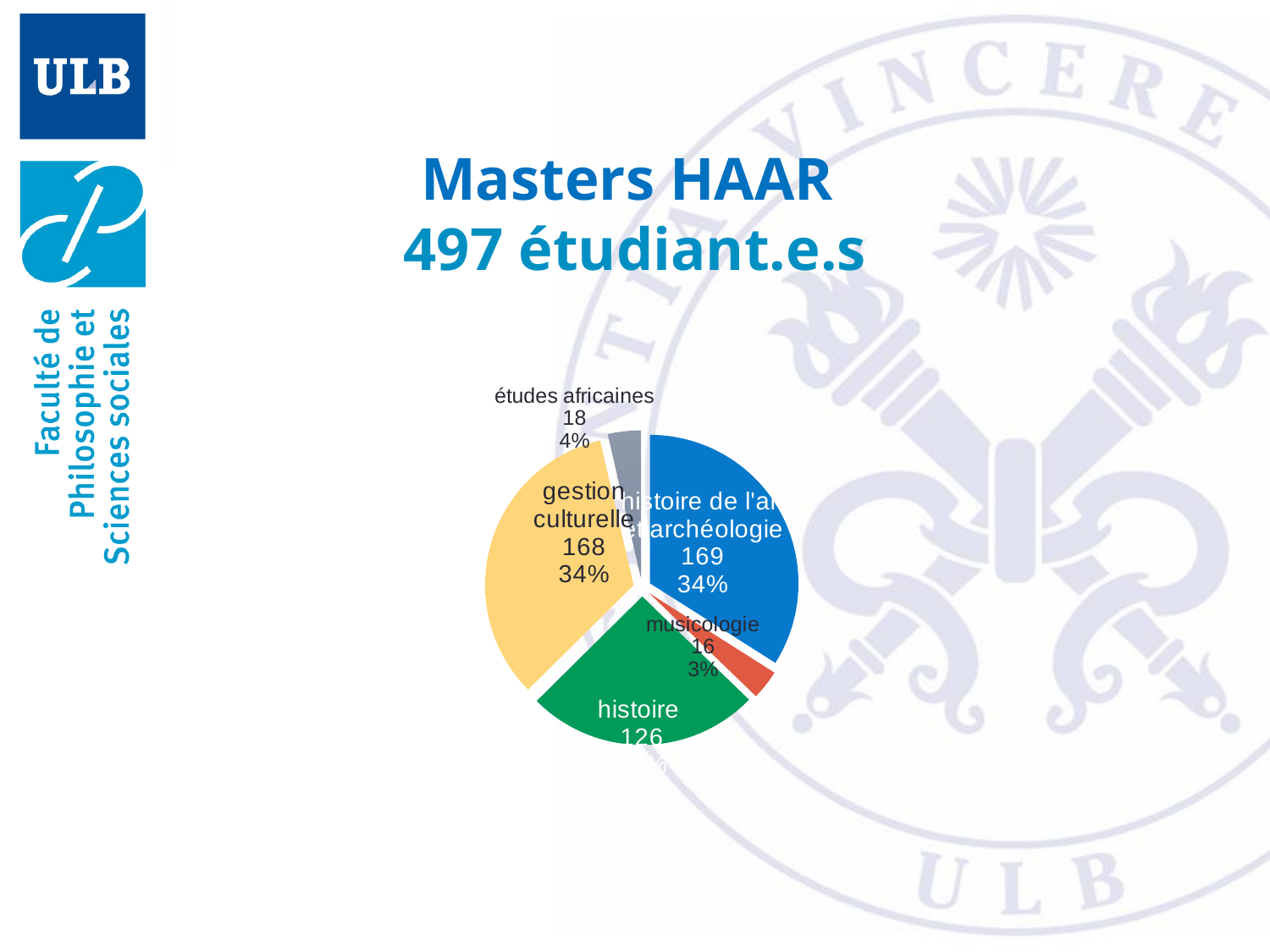
How many students are in gestion culturelle? 168 What percentage of the pie does musicologie represent? 3% What colour is the histoire slice? green What is the difference in student numbers between gestion culturelle and histoire? 42 How many slices does the pie chart have? 5 Which has more students, histoire or gestion culturelle? gestion culturelle What kind of chart is shown on the slide? pie chart How many students are in histoire? 126 How many students are in histoire de l'art et archéologie? 169 What is the difference in student numbers between études africaines and musicologie? 2 What percentage of the pie does gestion culturelle represent? 34% What percentage of the pie does études africaines represent? 4%